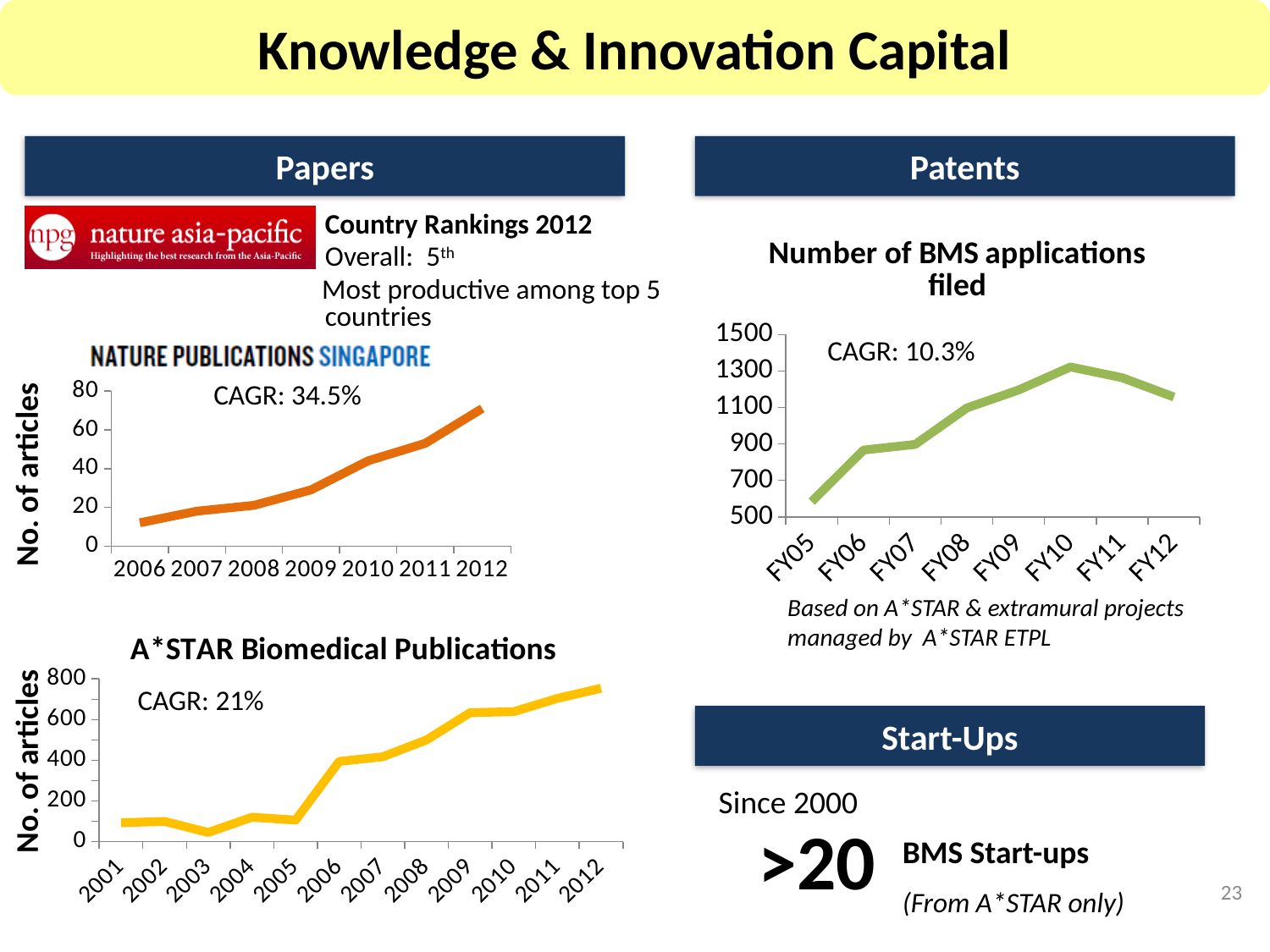
In the 'Number of BMS applications filed' chart, which fiscal year has the highest value? FY10 What CAGR is stated on the 'Number of BMS applications filed' chart? 10.3% In the 'Number of BMS applications filed' chart, is the value for FY12 greater or less than 1100? greater How many years are plotted in the 'Nature Publications Singapore' chart? 7 What kind of chart is the 'Number of BMS applications filed' chart? line chart In the 'A*STAR Biomedical Publications' chart, which year has the lowest number of articles? 2003 In the 'Nature Publications Singapore' chart, which year has the highest number of articles? 2012 In the 'A*STAR Biomedical Publications' chart, is the value for 2012 greater or less than 600? greater In the 'Number of BMS applications filed' chart, which fiscal year has the lowest value? FY05 In the 'Number of BMS applications filed' chart, is the value for FY05 greater or less than 700? less How many fiscal years are plotted in the 'Number of BMS applications filed' chart? 8